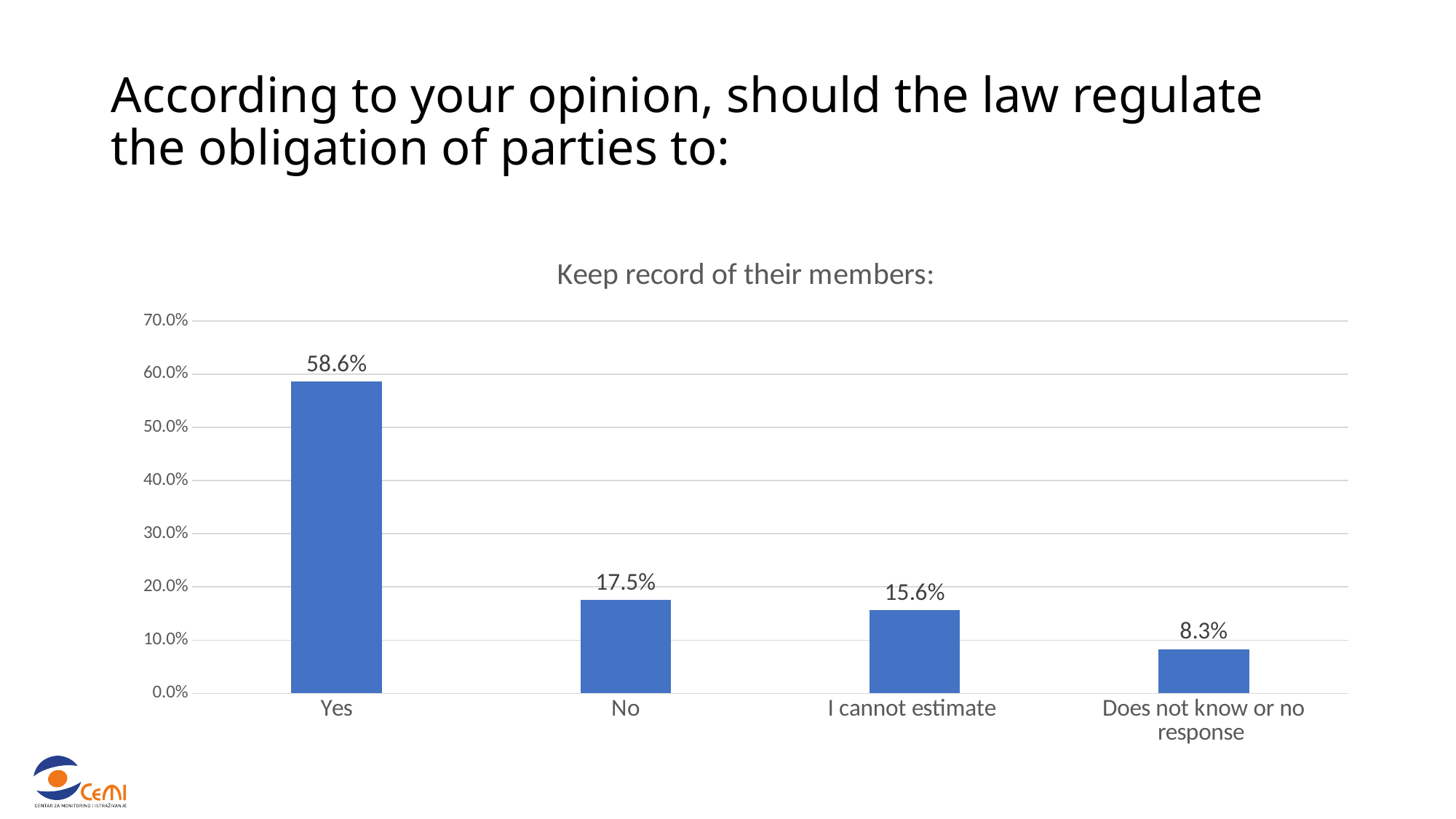
What percentage of respondents answered "Yes"? 58.6% Which is larger, the value for "No" or the value for "Does not know or no response"? No What is the difference between the values for "Yes" and "No"? 41.1% Which category has the lowest value? Does not know or no response What is the value for "I cannot estimate"? 15.6% What is the value for "Does not know or no response"? 8.3% What type of chart is shown on the slide? Bar chart What is the value for "No"? 17.5% How many categories are shown on the x axis? 4 What is the difference between the values for "No" and "I cannot estimate"? 1.9% Which category has the highest value? Yes Is the value for "Yes" greater or less than 50.0%? greater